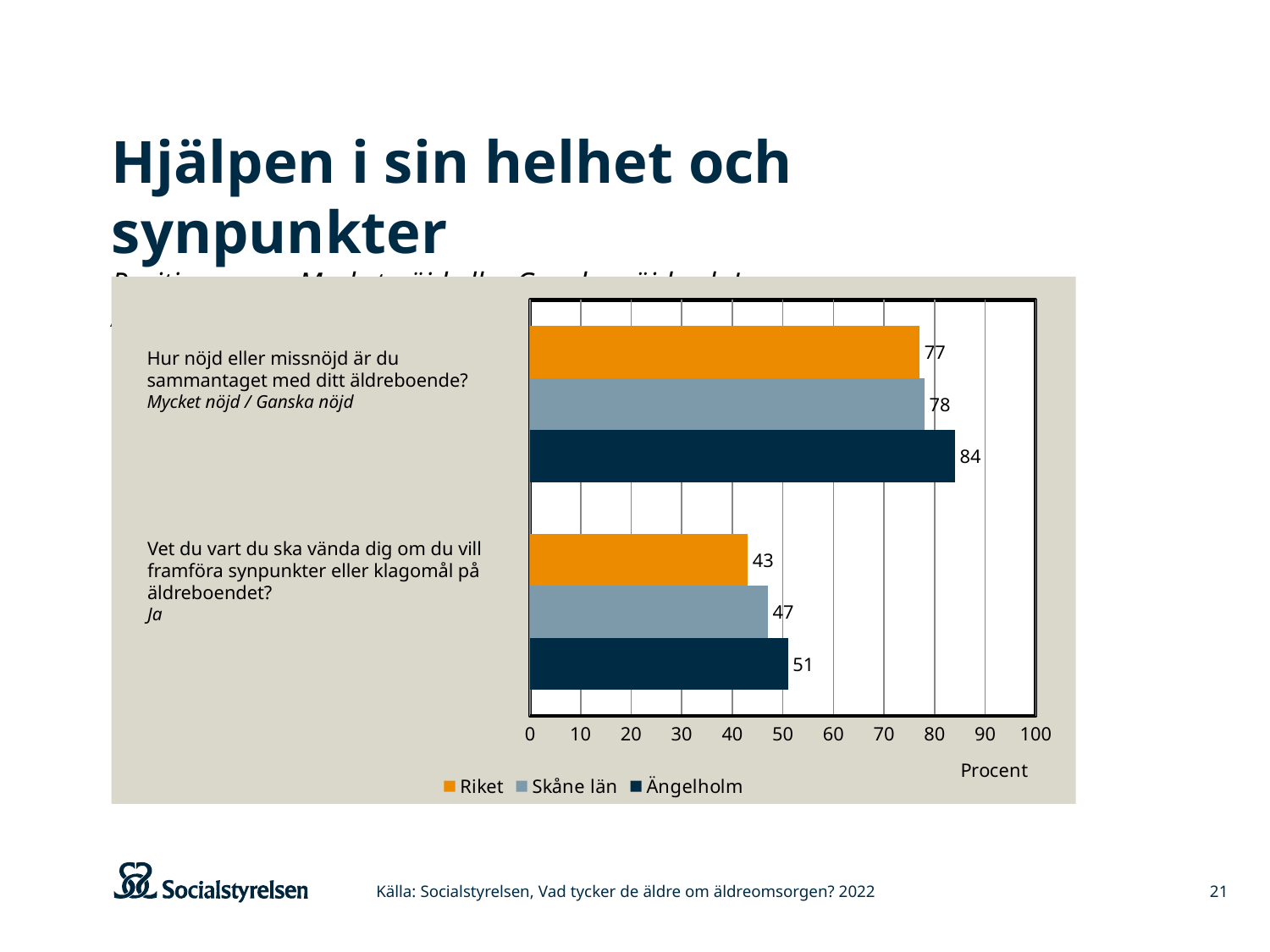
Which series has the lowest value on the question about overall satisfaction with the äldreboende? Riket Which series has the highest value on the question about knowing where to turn with synpunkter or klagomål? Ängelholm How many series does the legend list? 3 Is the value for Skåne län on the question about knowing where to turn with synpunkter greater or less than 50? less What unit is shown on the x axis of the chart? Procent What is the difference between Skåne län and Riket on the question about knowing where to turn with synpunkter or klagomål? 4 What kind of chart is shown on the slide? Bar chart What is the value for Skåne län on the question about overall satisfaction with the äldreboende? 78 Which is larger: Ängelholm's value for overall satisfaction or Ängelholm's value for knowing where to turn with synpunkter? Overall satisfaction (84) What is the value for Ängelholm on the question about how satisfied residents are overall with their äldreboende? 84 What is the value for Riket on the question about knowing where to turn to give synpunkter or klagomål? 43 What is the difference between Ängelholm and Riket on the question about overall satisfaction with the äldreboende? 7